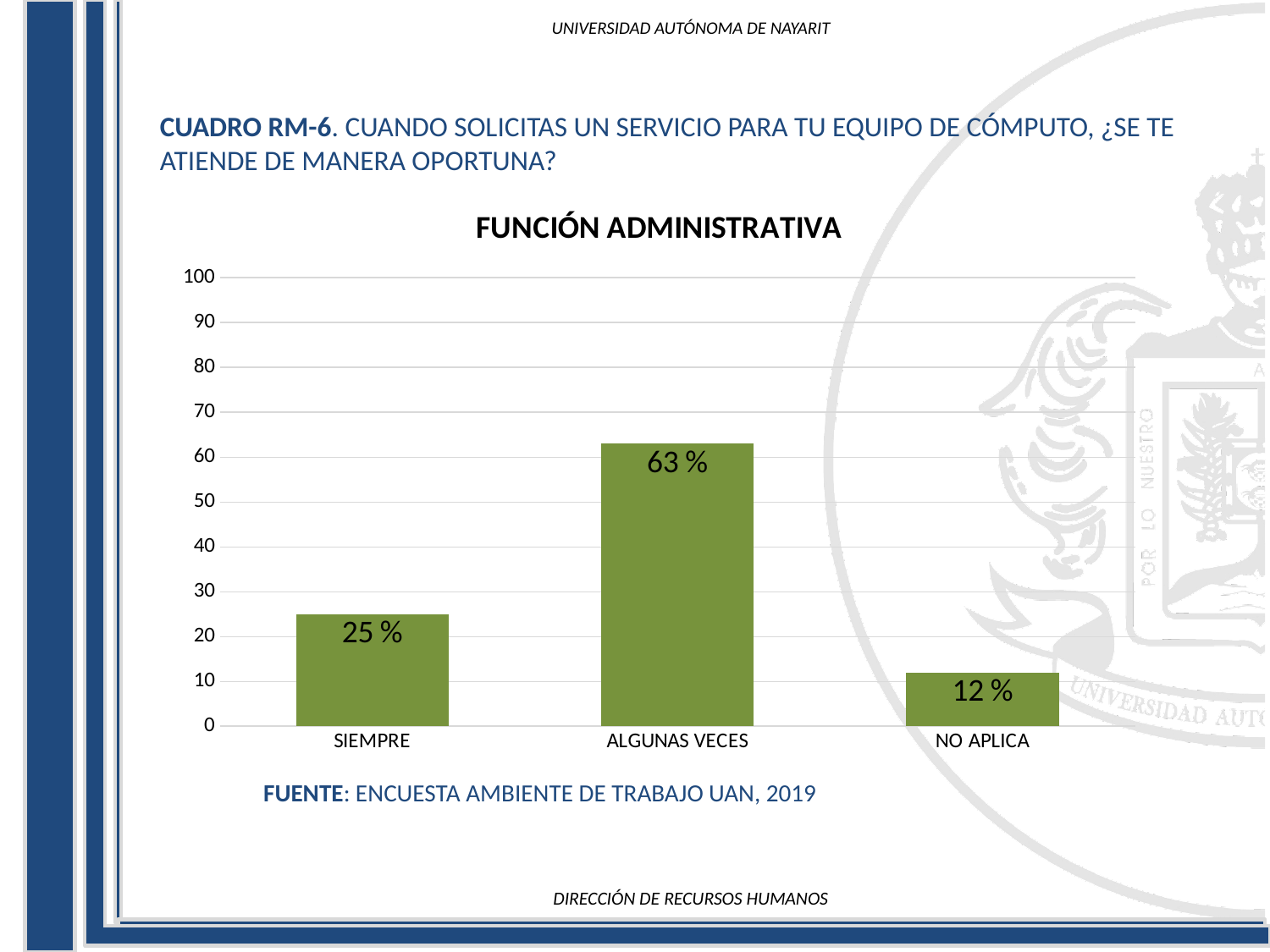
What is the value for SIEMPRE? 25 % What is the value for ALGUNAS VECES? 63 % Which category has the highest value? ALGUNAS VECES How many categories are shown on the x axis? 3 Is the value for ALGUNAS VECES greater or less than 50? greater What is the difference between the values for ALGUNAS VECES and SIEMPRE? 38 % What is the value for NO APLICA? 12 % What is the title of the chart? FUNCIÓN ADMINISTRATIVA Which category has the lowest value? NO APLICA What is the difference between the values for SIEMPRE and NO APLICA? 13 % Which is larger, the value for SIEMPRE or the value for NO APLICA? SIEMPRE What kind of chart is shown on the slide? bar chart